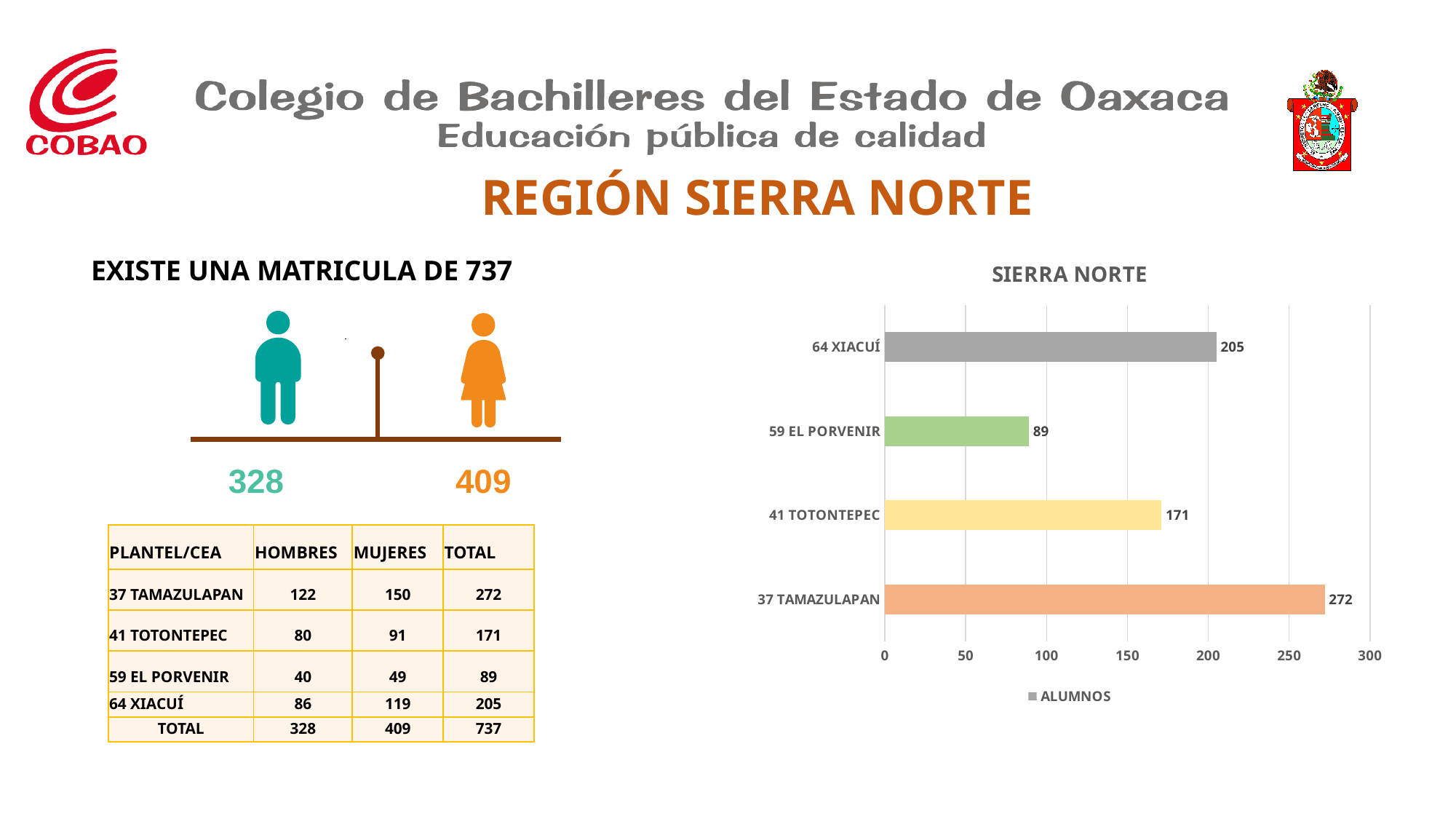
What is the value for 64 XIACUÍ in the SIERRA NORTE chart? 205 What is the value for 59 EL PORVENIR in the SIERRA NORTE chart? 89 Which category has the highest value in the SIERRA NORTE chart? 37 TAMAZULAPAN What is the value for 37 TAMAZULAPAN in the SIERRA NORTE chart? 272 How many categories are shown in the SIERRA NORTE chart? 4 Which is larger in the SIERRA NORTE chart, 64 XIACUÍ or 41 TOTONTEPEC? 64 XIACUÍ What is the difference between the values for 37 TAMAZULAPAN and 64 XIACUÍ in the SIERRA NORTE chart? 67 What is the value for 41 TOTONTEPEC in the SIERRA NORTE chart? 171 Which category has the lowest value in the SIERRA NORTE chart? 59 EL PORVENIR Is the value for 59 EL PORVENIR in the SIERRA NORTE chart greater or less than 100? less What kind of chart is the SIERRA NORTE chart? bar chart What series name does the legend of the SIERRA NORTE chart show? ALUMNOS